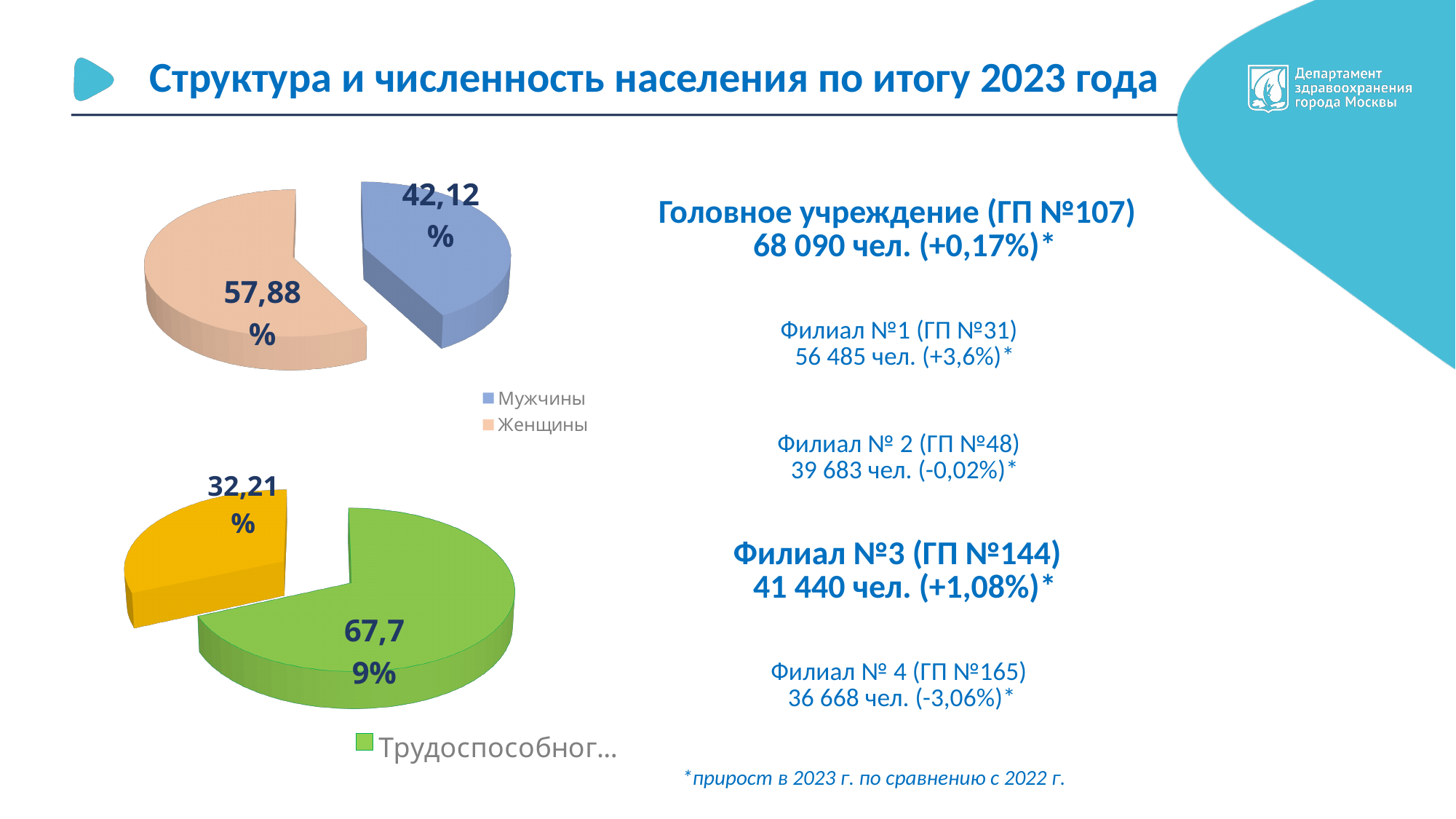
What type of chart is the top chart on the slide? Pie chart In the top pie chart, what percentage is shown for Женщины? 57,88% In the top pie chart, how many slices are there? 2 In the bottom pie chart, what percentage is shown on the green slice? 67,79% How many entries does the legend of the top chart list? 2 In the top pie chart, which category has the larger share, Мужчины or Женщины? Женщины In the top pie chart, what is the difference in percentage points between Женщины and Мужчины? 15,76 In the top pie chart, which colour represents Мужчины? Blue In the top pie chart, what percentage is shown for Мужчины? 42,12% In the bottom pie chart, what is the difference in percentage points between the green slice and the yellow slice? 35,58 In the bottom pie chart, which slice is larger, the green one or the yellow one? The green one In the bottom pie chart, what percentage is shown on the yellow slice? 32,21%